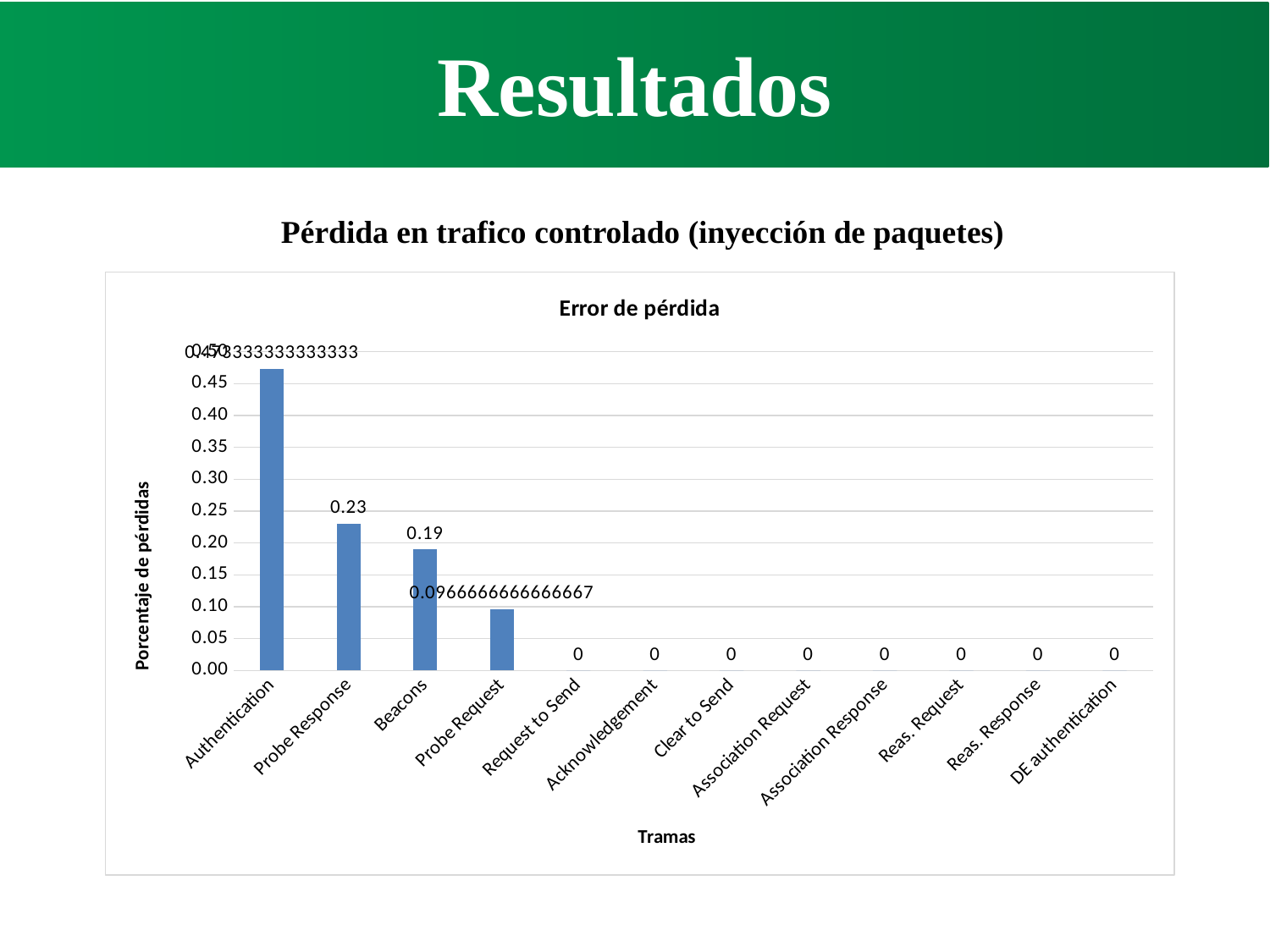
What is the value for Probe Request in the Error de pérdida chart? 0.0966666666666667 What is the difference between the values for Probe Response and Beacons? 0.04 How many categories are shown on the x axis of the Error de pérdida chart? 12 Which is larger, the value for Beacons or the value for Probe Request? Beacons What is the value for Beacons in the Error de pérdida chart? 0.19 What is the title of the y axis in the Error de pérdida chart? Porcentaje de pérdidas What is the value for Clear to Send in the Error de pérdida chart? 0 What type of chart is shown on the slide? bar chart What is the value for Probe Response in the Error de pérdida chart? 0.23 Which category has the highest value in the Error de pérdida chart? Authentication Is the value for Authentication greater or less than 0.45? greater Is the value for Probe Request greater or less than 0.15? less